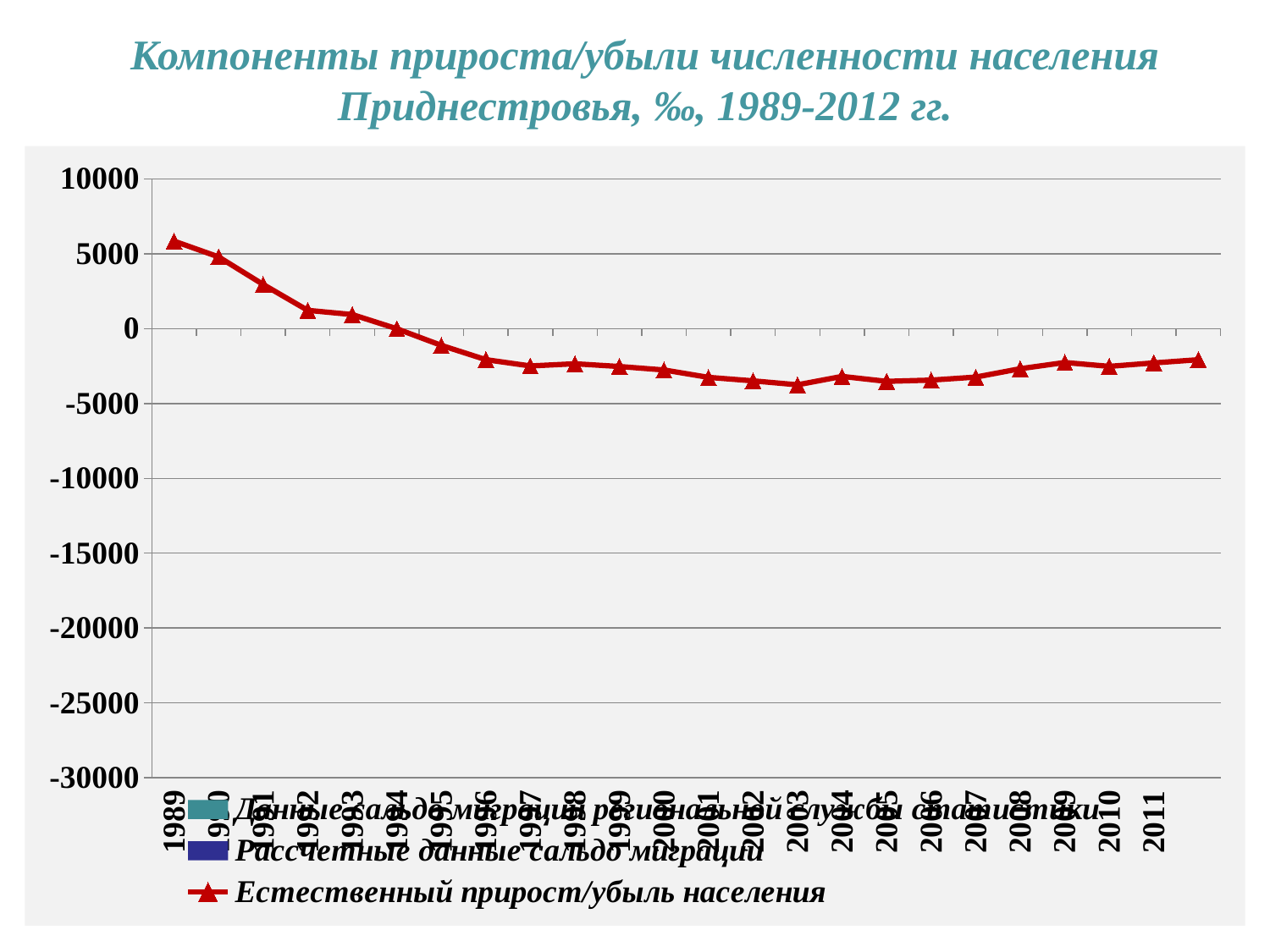
How many series does the legend list? 3 Which year has the lowest value for Естественный прирост/убыль населения? 2003 What kind of chart is shown on the slide? line chart What is the title of the chart? Компоненты прироста/убыли численности населения Приднестровья, ‰, 1989-2012 гг. Is the value for Естественный прирост/убыль населения in 2003 greater or less than -5000? greater Does the value for Естественный прирост/убыль населения rise or fall from 1989 to 1995? fall Which is larger, the value for Естественный прирост/убыль населения in 1989 or in 2011? 1989 Is the value for Естественный прирост/убыль населения in 1989 greater or less than 5000? greater Is the value for Естественный прирост/убыль населения in 1996 greater or less than 0? less Which is larger, the value for Естественный прирост/убыль населения in 1991 or in 1996? 1991 Which year has the highest value for Естественный прирост/убыль населения? 1989